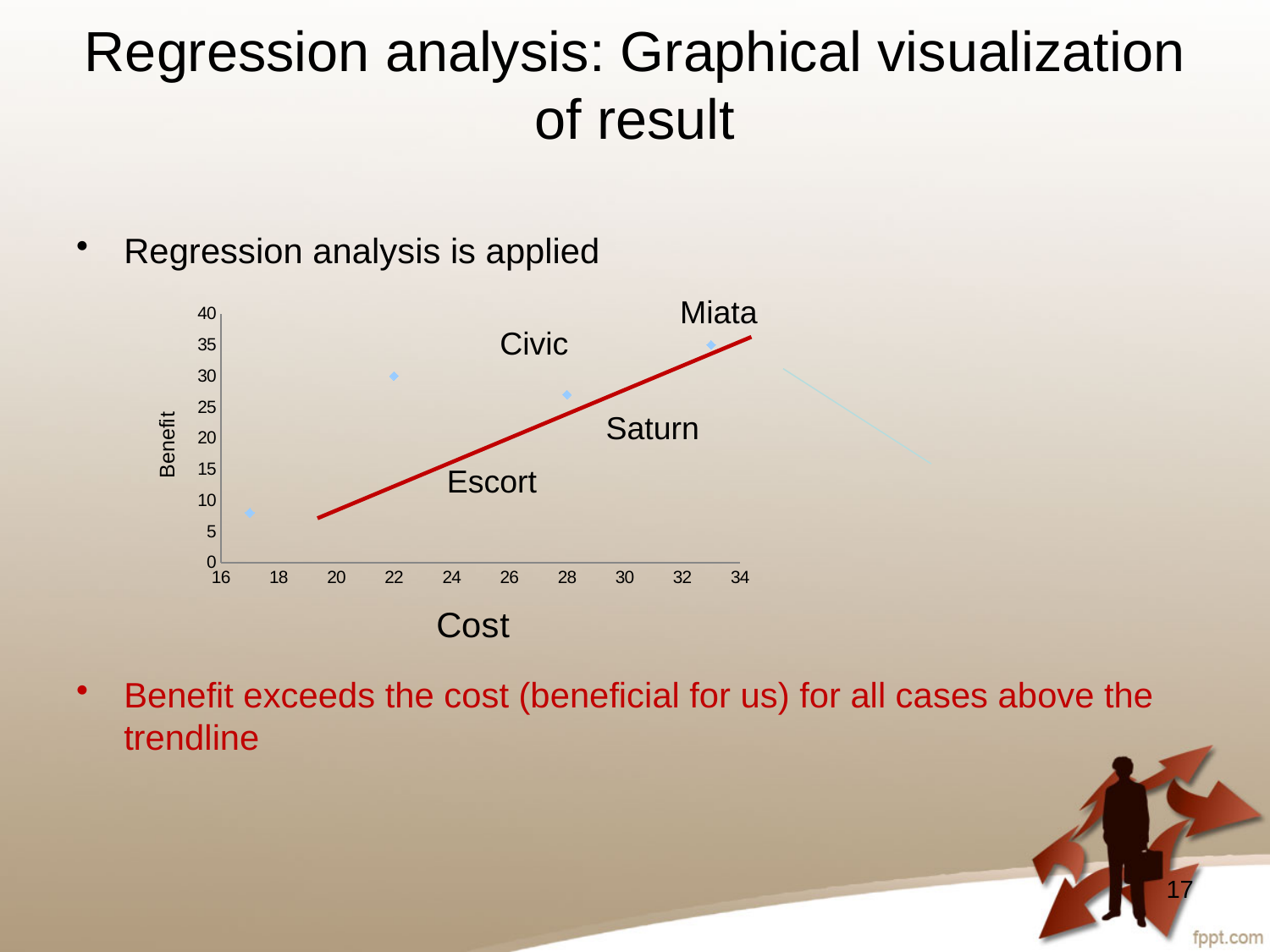
Which has the higher benefit value, Civic or Escort? Civic What is the label of the horizontal axis of the chart? Cost Is the benefit value for Miata greater or less than 30? greater What is the label of the vertical axis of the chart? Benefit Which car has the highest benefit value on the chart? Miata Is the cost value for Escort greater or less than 18? less How many data points are plotted on the chart? 4 Is the benefit value for Escort greater or less than 10? less Does the red trendline rise or fall as cost increases along the x axis? rises Which car has the lowest benefit value on the chart? Escort What kind of chart is shown on the slide? scatter chart